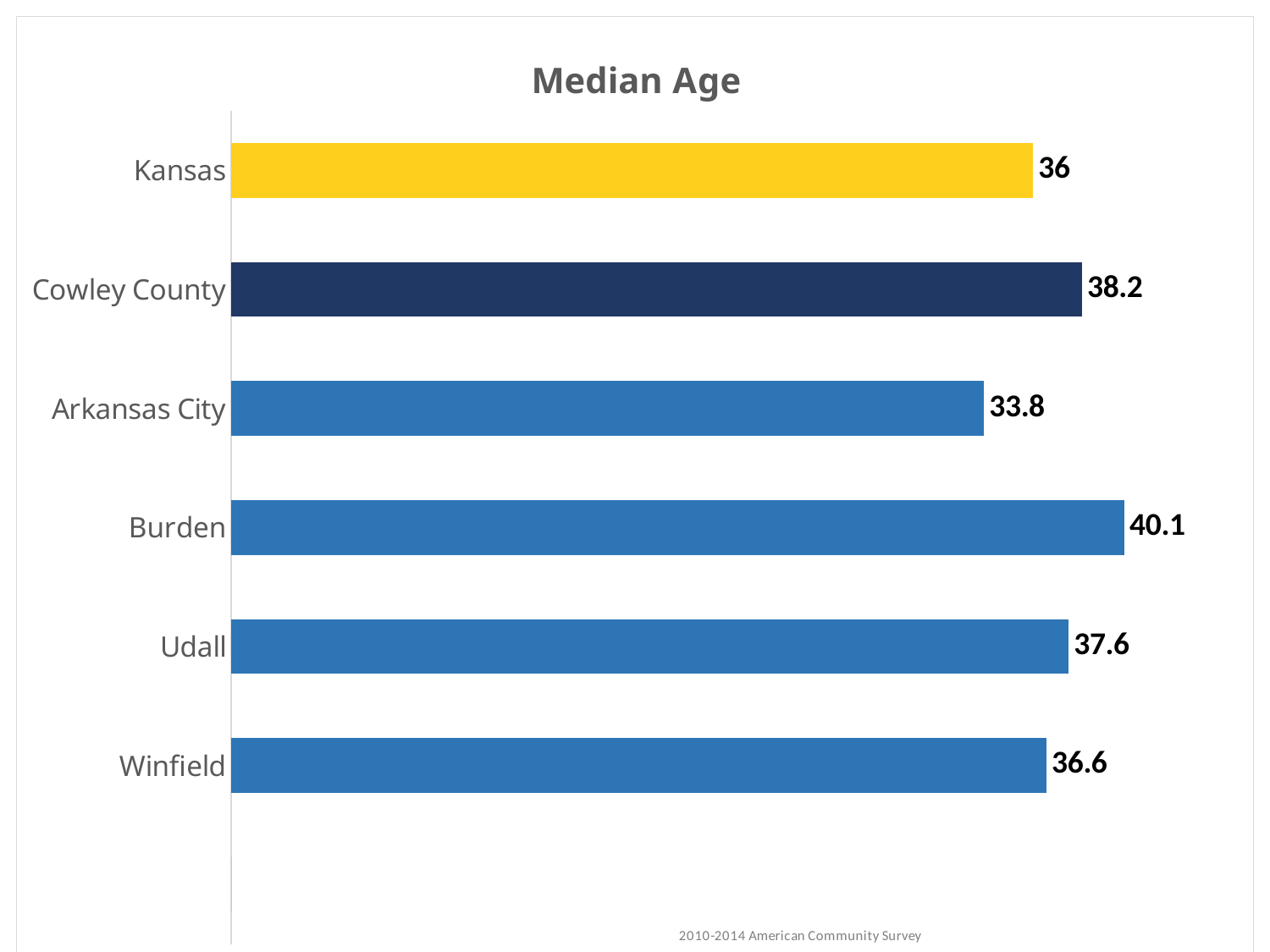
What is the difference between the median age of Cowley County and Kansas? 2.2 What is the title of the chart? Median Age Which has a higher median age, Udall or Winfield? Udall Which category has the lowest median age? Arkansas City What is the difference between the median age of Burden and Arkansas City? 6.3 What is the median age for Cowley County? 38.2 What is the median age for Arkansas City? 33.8 How many categories are shown in the chart? 6 What is the median age for Kansas? 36 Which category has the highest median age? Burden What is the median age for Winfield? 36.6 What kind of chart is this? Bar chart